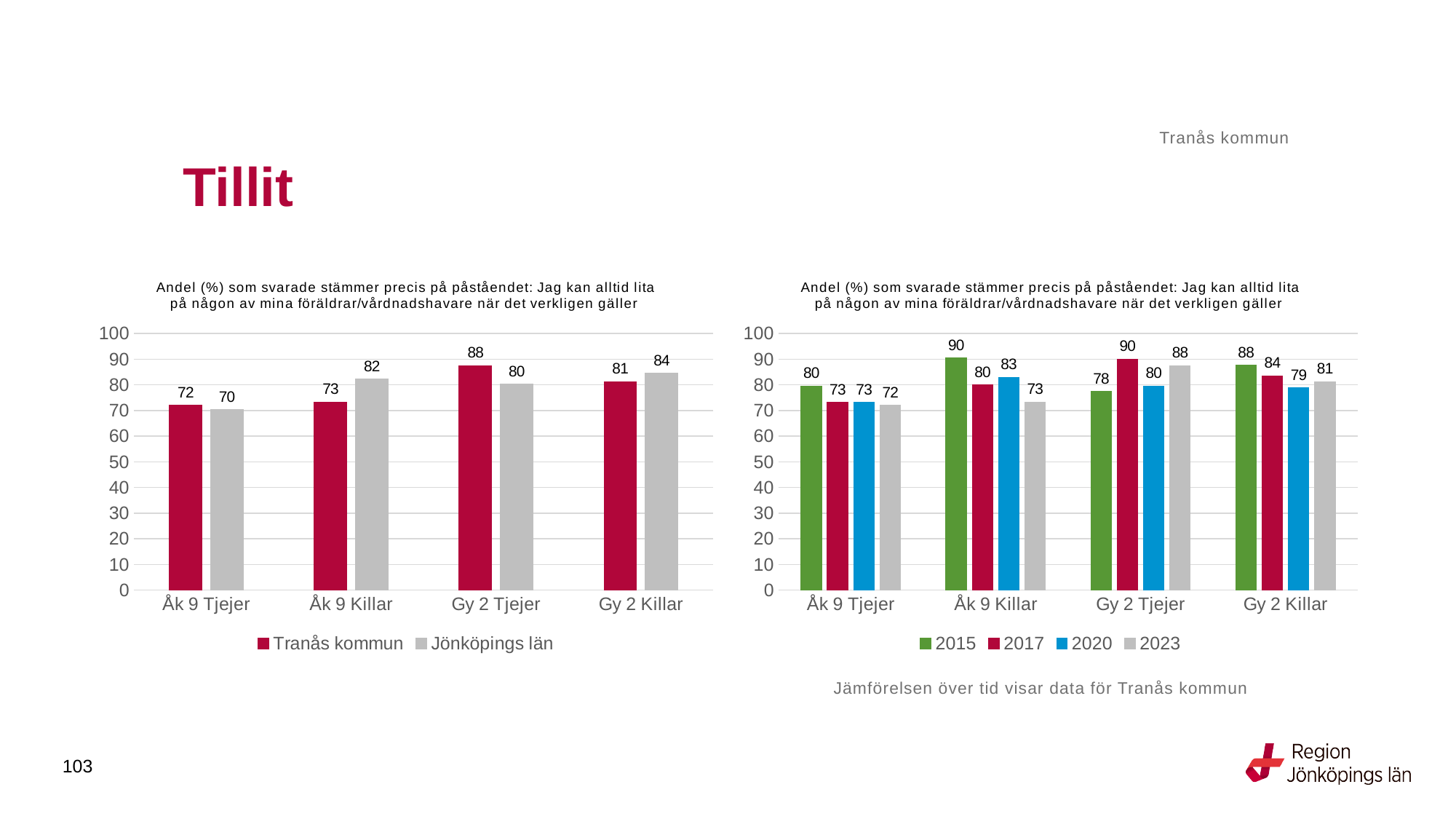
How many series does the legend of the right chart list? 4 In the left chart, what is the value for Tranås kommun for Gy 2 Tjejer? 88 In the left chart, which is larger for Gy 2 Killar: Tranås kommun or Jönköpings län? Jönköpings län In the right chart, what is the difference between the 2015 and 2023 values for Åk 9 Killar? 17 In the left chart, which category has the lowest value for Jönköpings län? Åk 9 Tjejer In the left chart, what is the value for Jönköpings län for Åk 9 Killar? 82 In the right chart, which year has the highest value for Åk 9 Killar? 2015 How many series does the legend of the left chart list? 2 What type of chart is the right chart? Bar chart In the left chart, what is the difference between Tranås kommun and Jönköpings län for Åk 9 Killar? 9 In the right chart, what is the value for 2020 for Åk 9 Killar? 83 In the right chart, what is the value for 2023 for Gy 2 Tjejer? 88